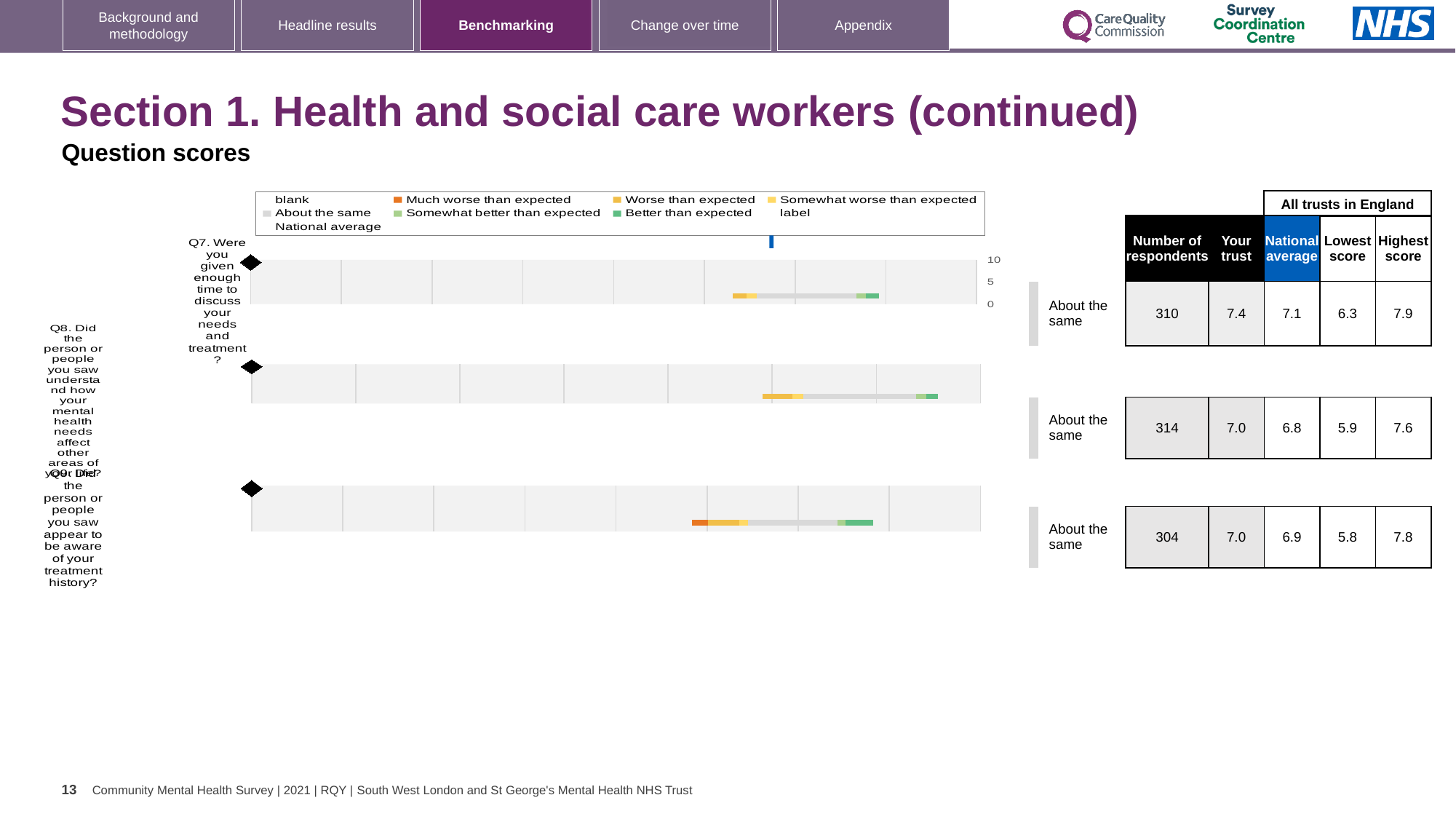
What is the difference between the highest score and the lowest score for Q7? 1.6 What is the national average score for Q8 (Did the person or people you saw understand how your mental health needs affect other areas of your life?)? 6.8 What is the difference between the 'Your trust' score and the national average for Q8? 0.2 What is the 'Your trust' score for Q7 (Were you given enough time to discuss your needs and treatment?)? 7.4 How many respondents answered Q9 (Did the person or people you saw appear to be aware of your treatment history?)? 304 What is the lowest score among all trusts in England for Q9? 5.8 What benchmark category is shown next to each of the three questions? About the same Which question has the highest 'Your trust' score? Q7 For Q7, which is larger: the 'Your trust' score or the national average? Your trust What type of chart is used to show the question scores on this slide? bar chart Which question has the lowest number of respondents? Q9 How many survey questions are plotted on this slide? 3